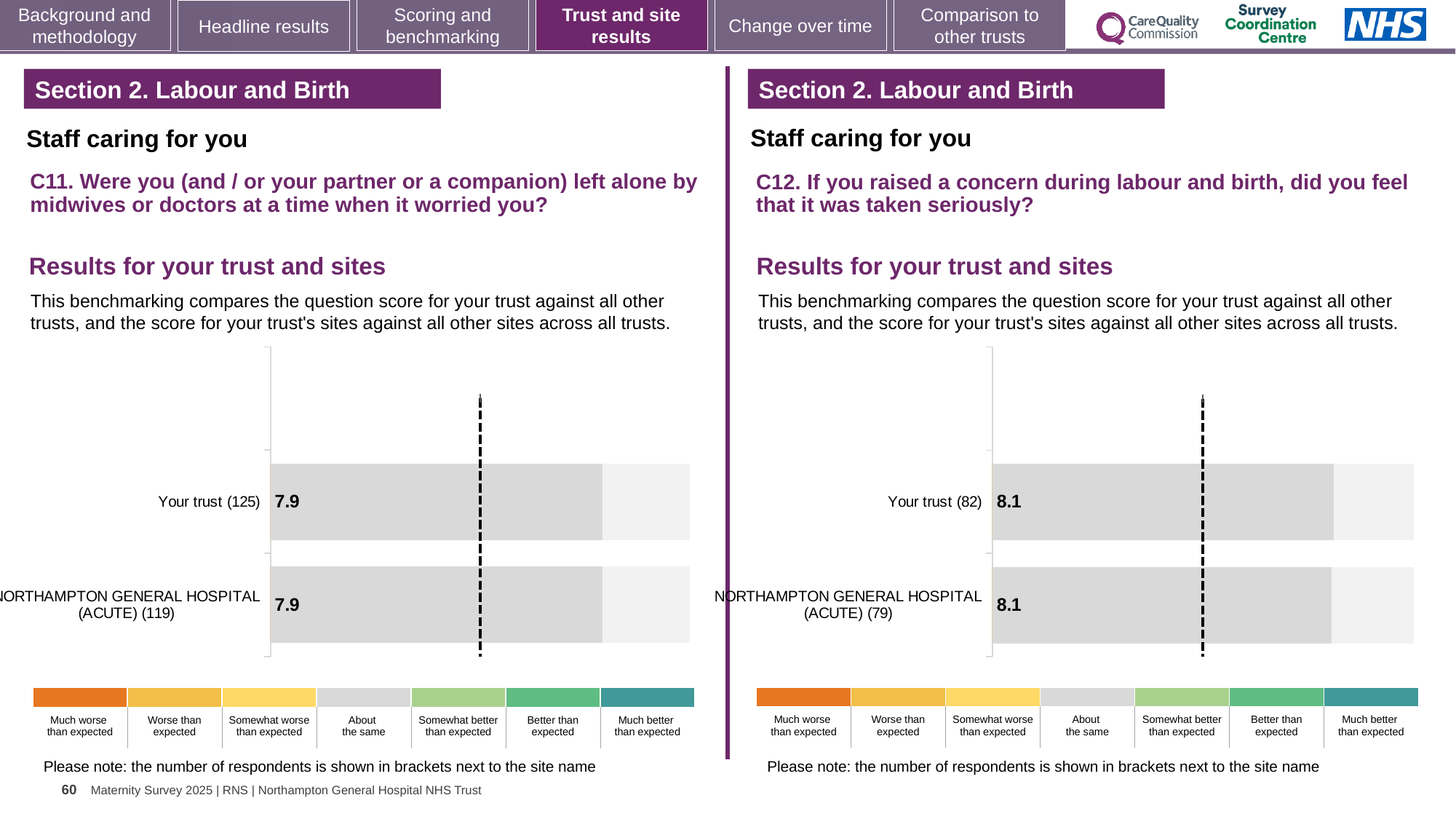
In the C11 chart on the left, what is the score for Your trust (125)? 7.9 In the C11 chart on the left, which benchmark category does the grey colour of the bars correspond to in the legend? About the same In the C11 chart on the left, what is the difference between the score for Your trust and the score for Northampton General Hospital (Acute)? 0 How many bars are plotted in the C11 chart on the left? 2 How many bars are plotted in the C12 chart on the right? 2 Is the score for Your trust in the C12 chart on the right higher or lower than the score for Your trust in the C11 chart on the left? Higher What kind of chart is used for the C11 results on the left? Bar chart In the C12 chart on the right, what is the score for Your trust (82)? 8.1 In the C12 chart on the right, what is the score for Northampton General Hospital (Acute) (79)? 8.1 In the C12 chart on the right, what is the difference between the score for Your trust and the score for Northampton General Hospital (Acute)? 0 In the C11 chart on the left, what is the score for Northampton General Hospital (Acute) (119)? 7.9 How many respondents are shown in brackets for Your trust in the C12 chart on the right? 82